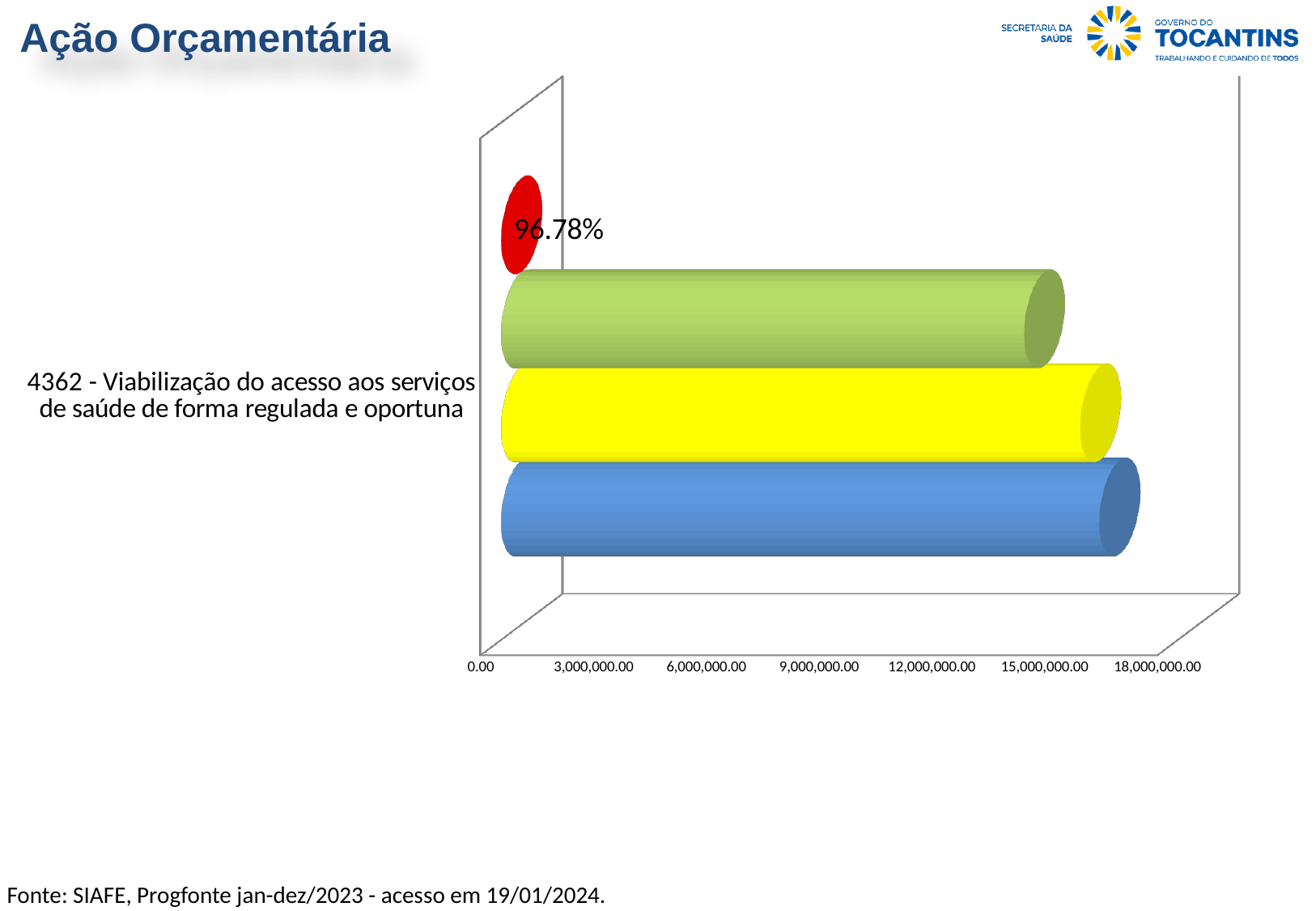
How many categories are shown on the chart's vertical axis? 1 Which coloured bar is the shortest on the chart? green Is the value of the green bar greater or less than 12,000,000.00? greater How many bars are plotted for the category on the chart? 3 What is the highest value shown on the chart's horizontal axis? 18,000,000.00 Is the value of the blue bar greater or less than 15,000,000.00? greater What is the category label shown on the chart? 4362 - Viabilização do acesso aos serviços de saúde de forma regulada e oportuna Is the value of the blue bar greater or less than 18,000,000.00? less What percentage is printed in the red oval on the chart? 96.78% Which is larger, the blue bar or the green bar? blue What kind of chart is shown on the slide? bar chart Which coloured bar is the longest on the chart? blue